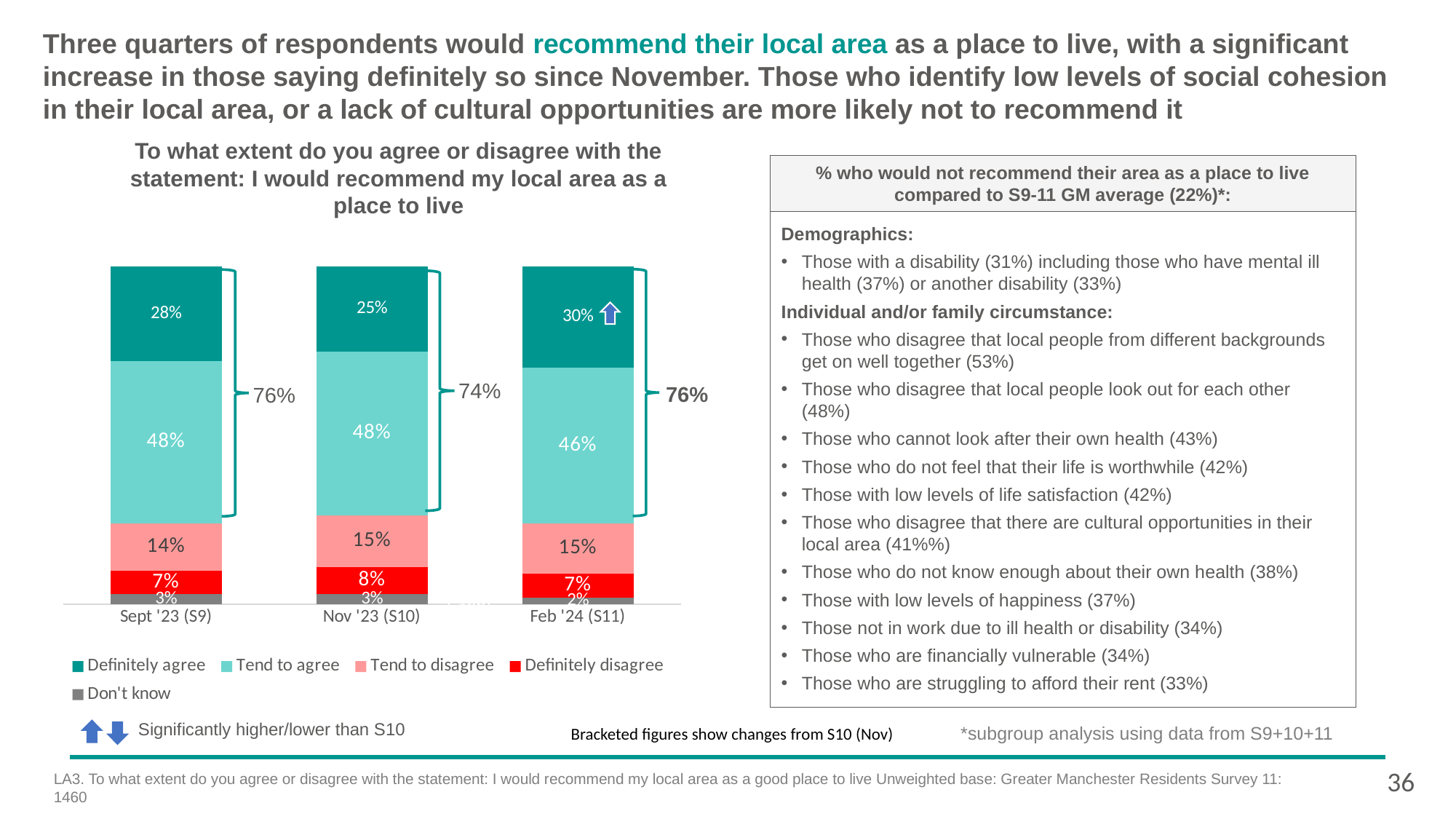
In which survey wave was the 'Definitely agree' share highest? Feb '24 (S11) What is the difference in the 'Definitely agree' share between Feb '24 (S11) and Nov '23 (S10)? 5 percentage points What percentage of respondents said 'Definitely agree' in Feb '24 (S11)? 30% How many series does the chart legend list? 5 What percentage of respondents said 'Tend to agree' in Sept '23 (S9)? 48% In which survey wave was the 'Definitely agree' share lowest? Nov '23 (S10) What type of chart is used to show the agreement with the statement about recommending the local area? Stacked bar chart What is the combined share of 'Definitely agree' and 'Tend to agree' shown by the bracket for Nov '23 (S10)? 74% How many survey waves are shown on the x axis of the chart? 3 What percentage of respondents said 'Don't know' in Feb '24 (S11)? 2% Which is larger: the 'Tend to agree' share in Nov '23 (S10) or in Feb '24 (S11)? Nov '23 (S10) What percentage of respondents said 'Definitely disagree' in Nov '23 (S10)? 8%